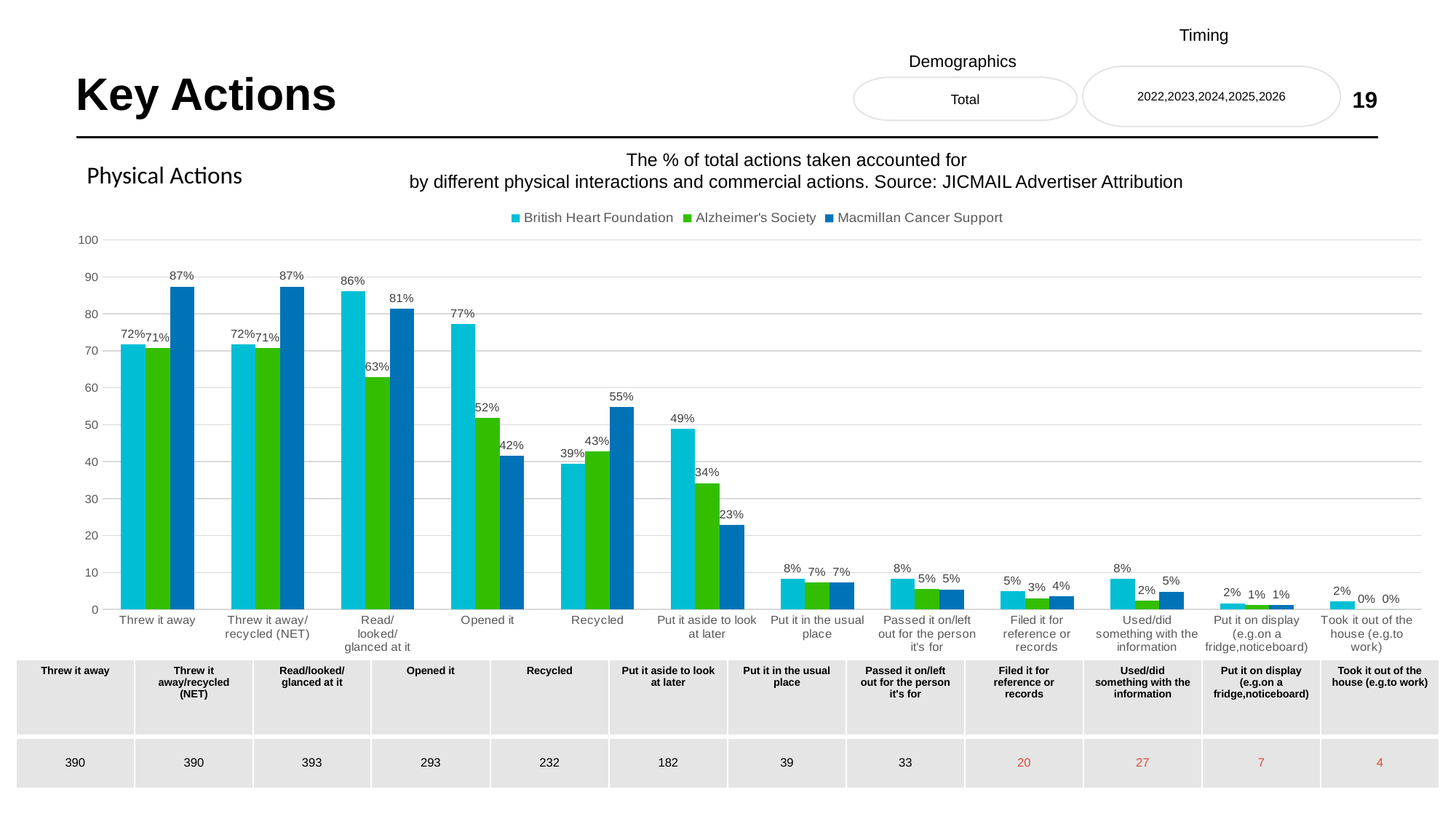
What is the difference between the British Heart Foundation and Alzheimer's Society values in the 'Opened it' category? 25% What is the value for British Heart Foundation in the 'Opened it' category? 77% What is the value for Macmillan Cancer Support in the 'Put it aside to look at later' category? 23% How many categories are shown on the x axis of the chart? 12 What kind of chart is shown on the slide? Bar chart Which series has the lowest value in the 'Opened it' category? Macmillan Cancer Support What is the value for Macmillan Cancer Support in the 'Threw it away' category? 87% Which series is shown in green in the chart legend? Alzheimer's Society Which series has the highest value in the 'Recycled' category? Macmillan Cancer Support Which is larger: the British Heart Foundation value for 'Recycled' or the Alzheimer's Society value for 'Recycled'? Alzheimer's Society What is the value for Alzheimer's Society in the 'Read/looked/glanced at it' category? 63% How many series does the chart legend list? 3